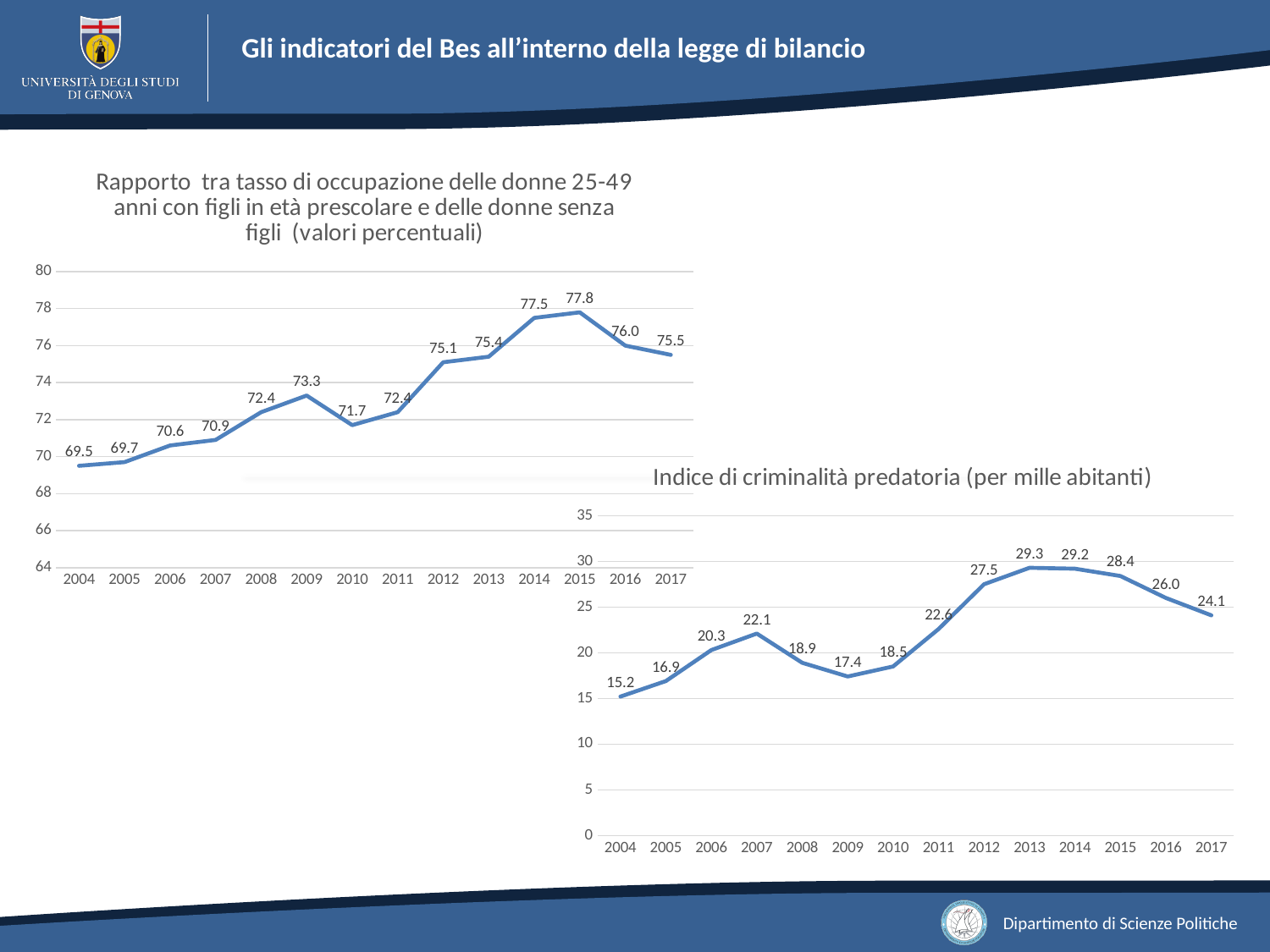
In the chart 'Rapporto tra tasso di occupazione delle donne 25-49 anni...', what is the value for 2015? 77.8 In the chart 'Rapporto tra tasso di occupazione delle donne 25-49 anni...', which year has the highest value? 2015 What kind of chart is 'Indice di criminalità predatoria (per mille abitanti)'? Line chart In the chart 'Rapporto tra tasso di occupazione delle donne 25-49 anni...', how many years are plotted? 14 In the chart 'Indice di criminalità predatoria (per mille abitanti)', what is the value for 2013? 29.3 In the chart 'Rapporto tra tasso di occupazione delle donne 25-49 anni...', which year has the lowest value? 2004 In the chart 'Indice di criminalità predatoria (per mille abitanti)', what is the value for 2017? 24.1 In the chart 'Rapporto tra tasso di occupazione delle donne 25-49 anni...', what is the difference between the values for 2017 and 2004? 6.0 In the chart 'Rapporto tra tasso di occupazione delle donne 25-49 anni...', what is the value for 2004? 69.5 In the chart 'Indice di criminalità predatoria (per mille abitanti)', what is the difference between the values for 2012 and 2009? 10.1 In the chart 'Indice di criminalità predatoria (per mille abitanti)', which year has the lowest value? 2004 In the chart 'Indice di criminalità predatoria (per mille abitanti)', which is larger, the value for 2007 or the value for 2011? 2011